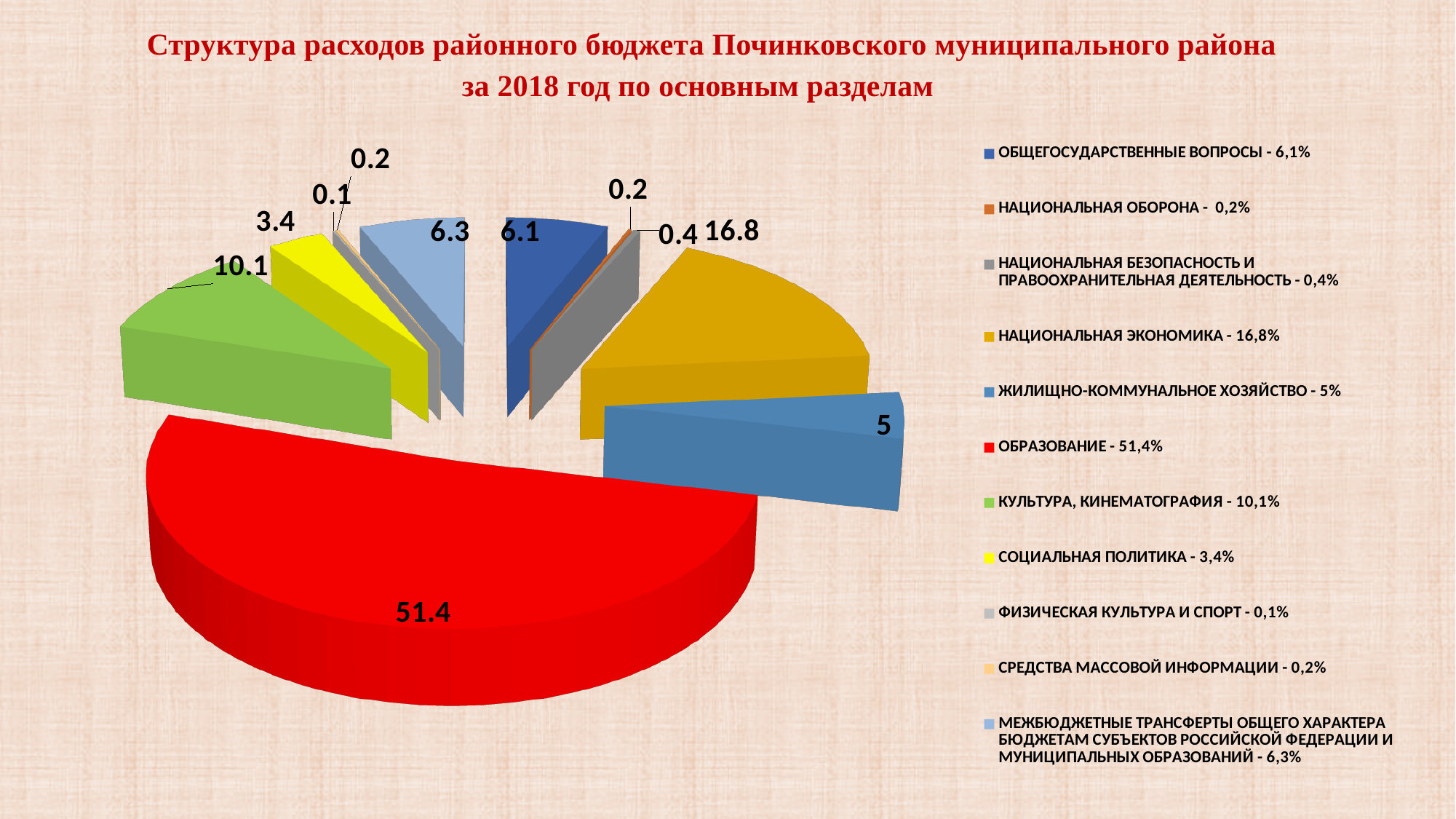
How many entries does the legend list? 11 What kind of chart is shown on the slide? Pie chart What share of the pie does ОБРАЗОВАНИЕ account for, according to the legend? 51,4% How many categories (slices) does the pie chart have? 11 Which category has the smallest slice of the pie chart? ФИЗИЧЕСКАЯ КУЛЬТУРА И СПОРТ What is the value shown for СОЦИАЛЬНАЯ ПОЛИТИКА on the pie chart? 3.4 What is the difference between the values for ОБРАЗОВАНИЕ and НАЦИОНАЛЬНАЯ ЭКОНОМИКА? 34.6 What is the difference between the values for КУЛЬТУРА, КИНЕМАТОГРАФИЯ and ЖИЛИЩНО-КОММУНАЛЬНОЕ ХОЗЯЙСТВО? 5.1 Which is larger, the value for КУЛЬТУРА, КИНЕМАТОГРАФИЯ or the value for ЖИЛИЩНО-КОММУНАЛЬНОЕ ХОЗЯЙСТВО? КУЛЬТУРА, КИНЕМАТОГРАФИЯ What is the value shown for НАЦИОНАЛЬНАЯ ЭКОНОМИКА on the pie chart? 16.8 What is the value shown for ОБРАЗОВАНИЕ on the pie chart? 51.4 Which category has the largest slice of the pie chart? ОБРАЗОВАНИЕ